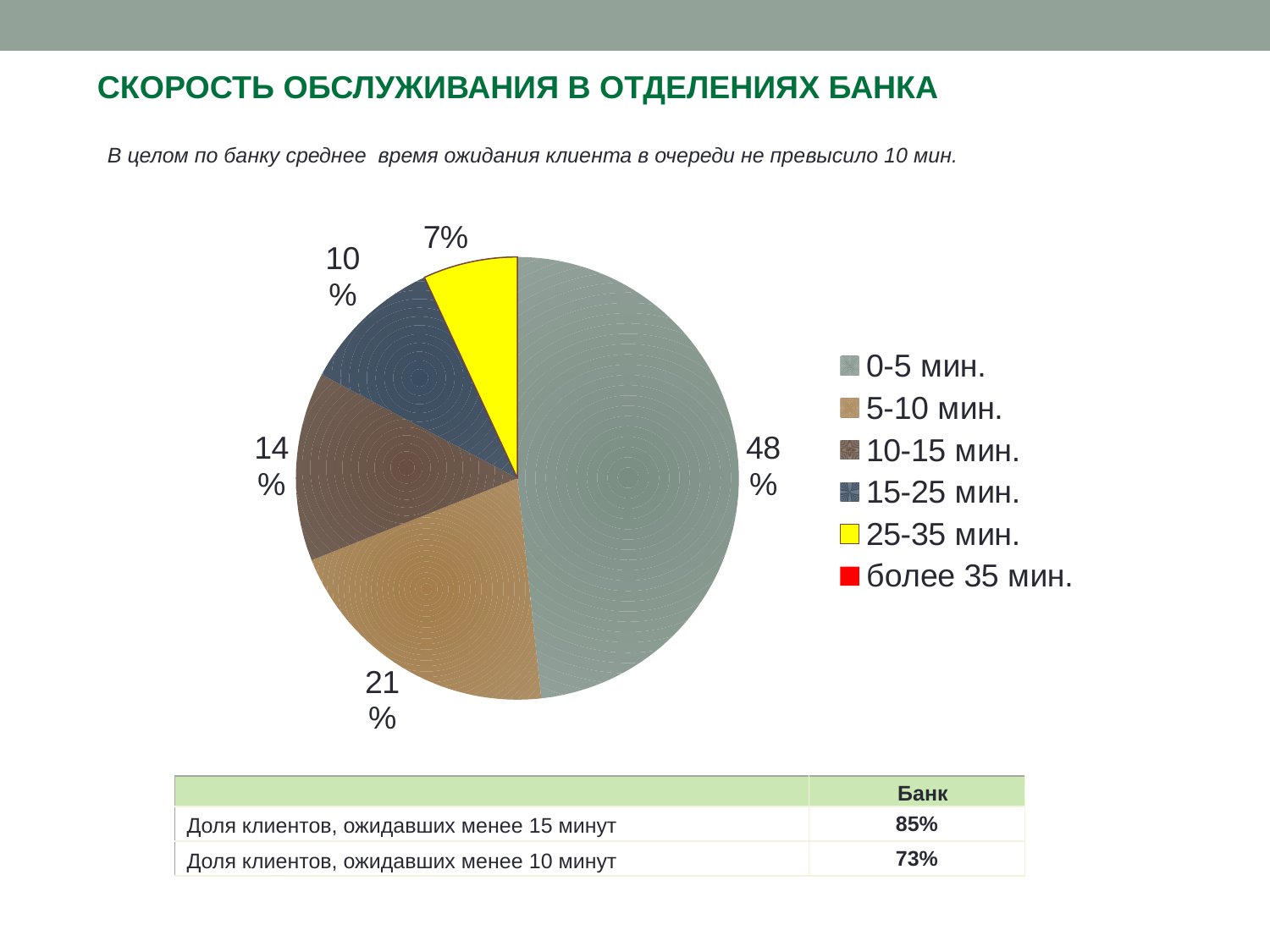
What is the difference in percentage points between the "0-5 мин." slice and the "5-10 мин." slice? 27 What kind of chart is shown on the slide? Pie chart How many entries does the legend list? 6 What share of the pie does the "15-25 мин." slice represent? 10% What share of the pie does the "5-10 мин." slice represent? 21% Which slice is larger: "10-15 мин." or "15-25 мин."? 10-15 мин. What share of the pie does the "0-5 мин." slice represent? 48% What colour is the "25-35 мин." slice in the pie chart? Yellow Which labelled slice of the pie is the smallest? 25-35 мин. Which category has the largest slice of the pie? 0-5 мин. What share of the pie does the "10-15 мин." slice represent? 14% What share of the pie does the "25-35 мин." slice represent? 7%